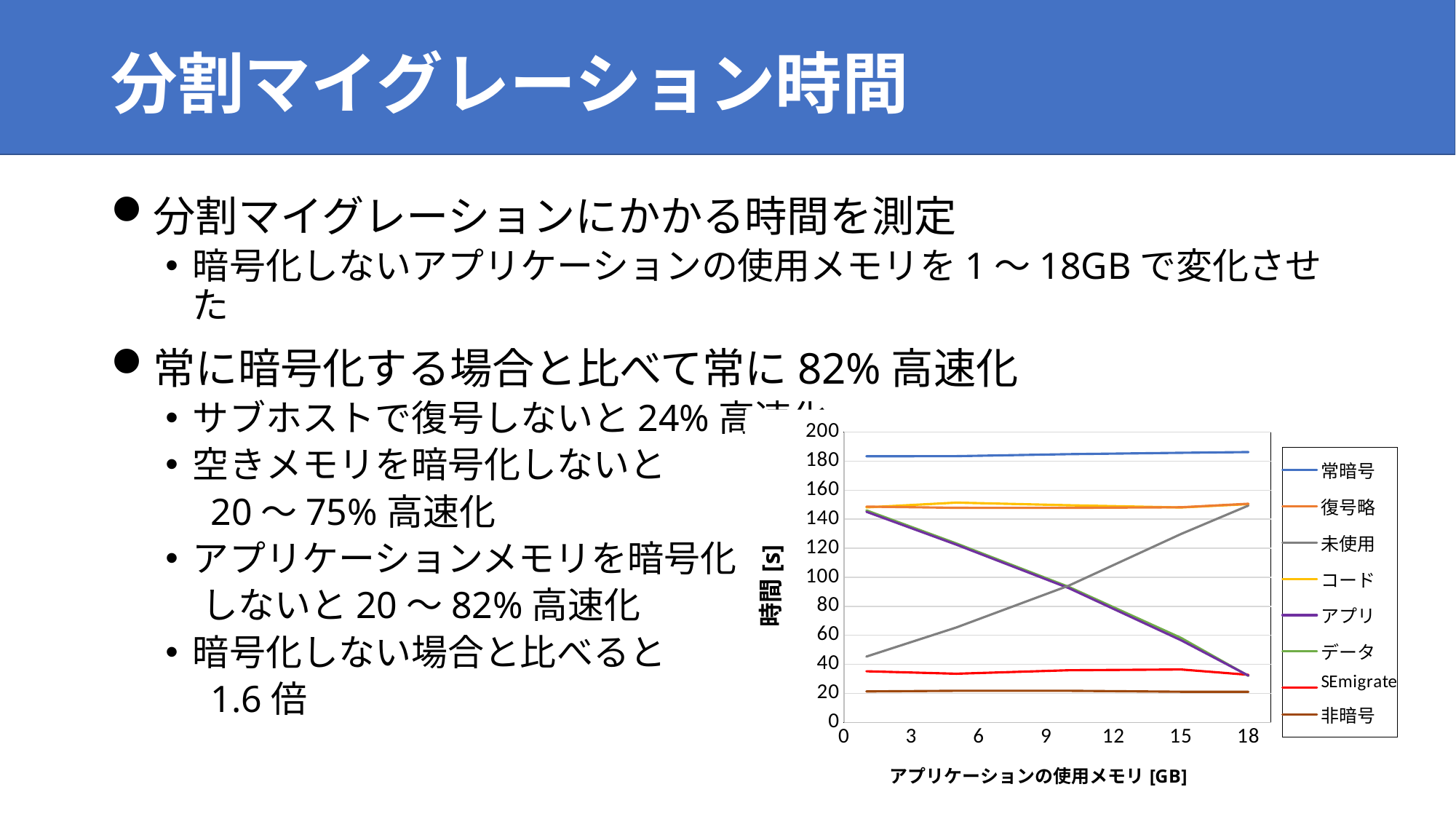
What kind of chart is shown on the slide? line chart How many series does the chart's legend list? 8 What is the title of the chart's x axis? アプリケーションの使用メモリ [GB] Which series has the highest values across the whole range of application memory? 常暗号 Does the 未使用 series rise or fall as application memory increases from 1 to 18 GB? rise At 15 GB of application memory, which is larger: 未使用 or アプリ? 未使用 Is the value for SEmigrate at 18 GB greater or less than 40? less Is the value for 非暗号 at 9 GB greater or less than 40? less At 3 GB of application memory, which is larger: 未使用 or アプリ? アプリ Is the value for 常暗号 at 18 GB greater or less than 160? greater Which series has the lowest values across the whole range of application memory? 非暗号 Does the アプリ series rise or fall as application memory increases from 1 to 18 GB? fall